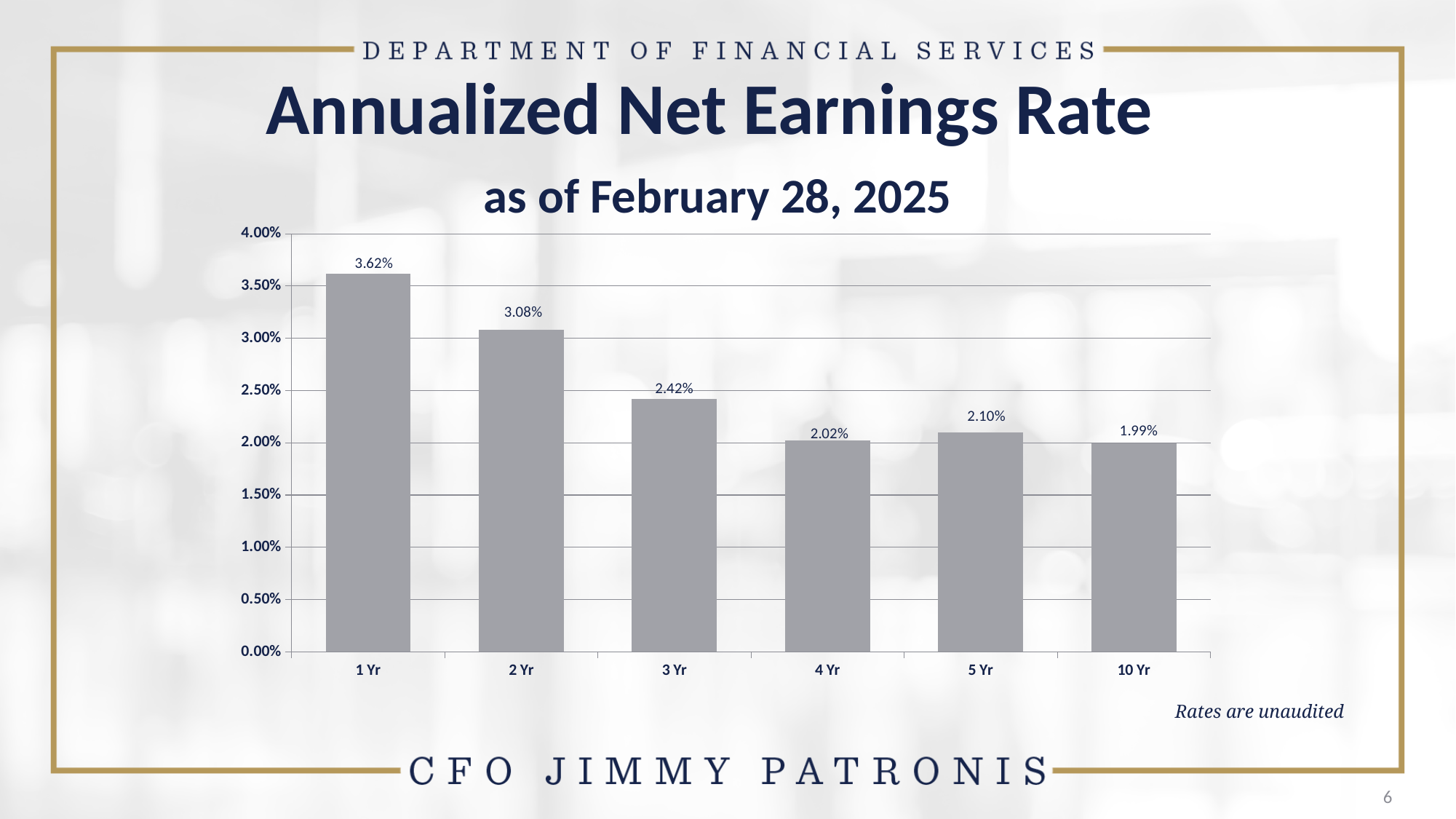
What is the annualized net earnings rate for 3 Yr? 2.42% Is the value for 4 Yr greater or less than 2.50%? less Which period has the highest annualized net earnings rate? 1 Yr What is the difference between the 1 Yr and 2 Yr annualized net earnings rates? 0.54% Which period has the lowest annualized net earnings rate? 10 Yr What is the annualized net earnings rate for 1 Yr? 3.62% How many periods are shown on the x axis of the chart? 6 Which is larger, the 2 Yr rate or the 3 Yr rate? 2 Yr What is the annualized net earnings rate for 10 Yr? 1.99% What is the date given in the chart's subtitle? February 28, 2025 What kind of chart is shown on the slide? Bar chart What is the difference between the 5 Yr and 4 Yr annualized net earnings rates? 0.08%